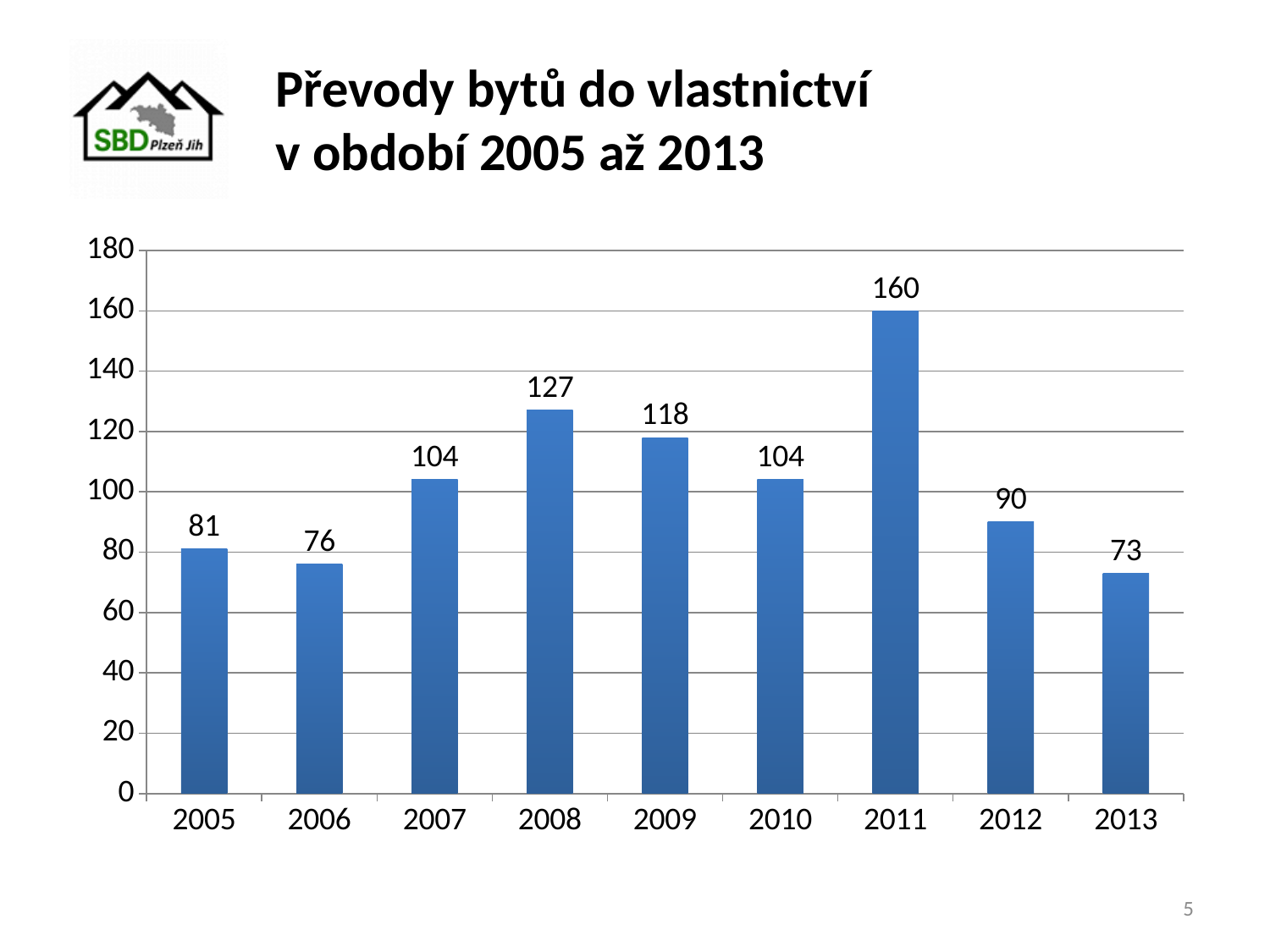
What is the difference between the values for 2008 and 2006? 51 What is the value for 2005? 81 What is the difference between the values for 2011 and 2012? 70 What is the value for 2011? 160 What kind of chart is shown on the slide? bar chart Which year has the highest value? 2011 How many years are shown on the x axis? 9 Is the value for 2008 greater or less than 120? greater Do the values rise or fall from 2011 to 2013? fall What is the value for 2009? 118 Which year has the lowest value? 2013 Which is larger, the value for 2007 or the value for 2012? 2007